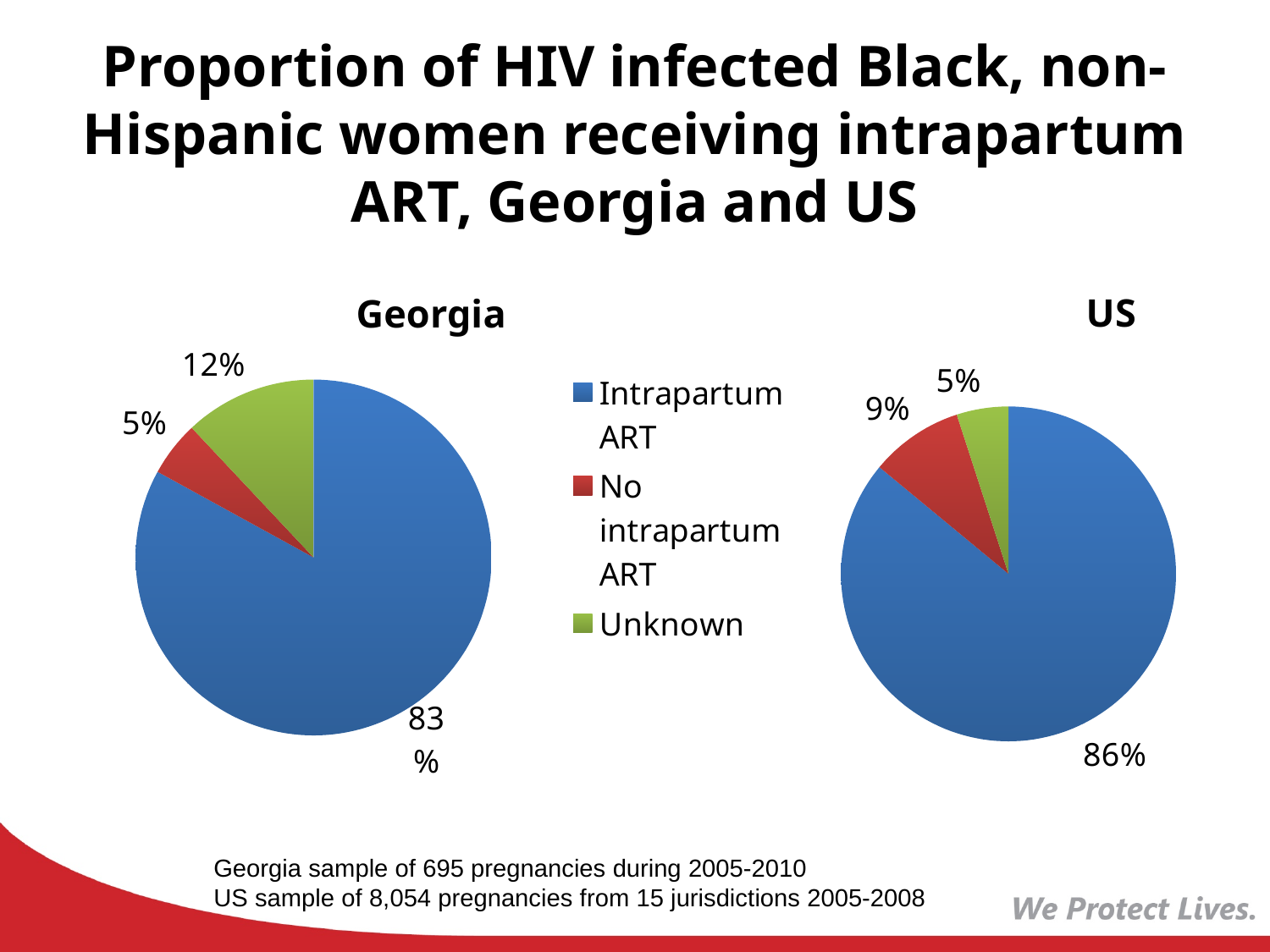
Is the Unknown share larger in the Georgia chart or the US chart? Georgia Which colour represents Unknown in the legend? Green What type of chart is used for the Georgia and US data? Pie chart In the US chart, what share is labelled No intrapartum ART? 9% In the Georgia chart, which category has the smallest slice? No intrapartum ART What is the difference between the intrapartum ART percentage in the US chart and in the Georgia chart? 3% How many categories does the legend list? 3 In the Georgia chart, what share is labelled Unknown? 12% In the US chart, which category has the smallest slice? Unknown In the US chart, what percentage of women received intrapartum ART? 86% In the Georgia chart, what percentage of women received intrapartum ART? 83% In the US chart, which category has the largest slice? Intrapartum ART